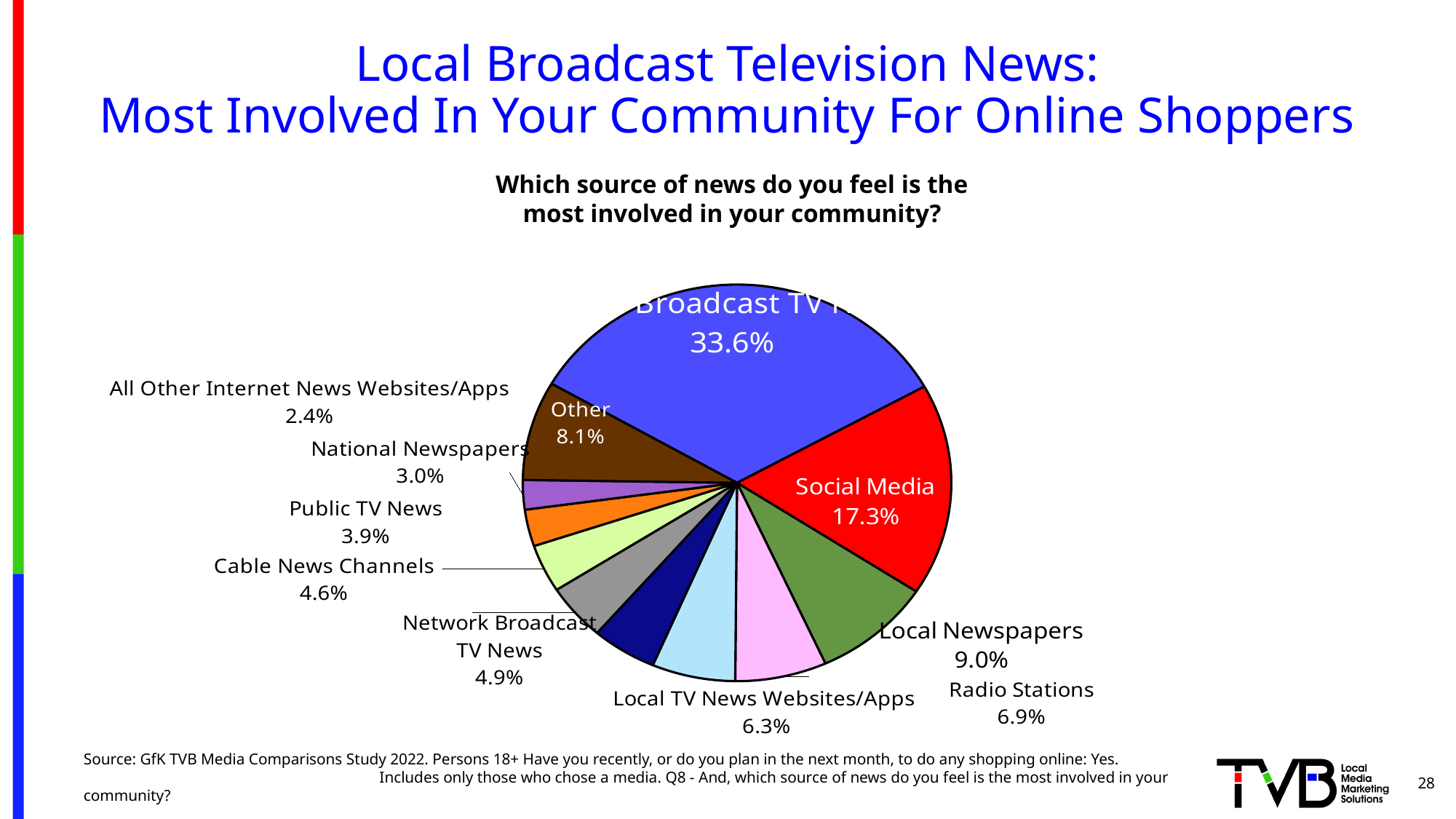
What percentage is shown for the Other slice? 8.1% Which is larger, Public TV News or National Newspapers? Public TV News What kind of chart is shown on the slide? pie chart How many percentage points higher is Social Media than Local Newspapers? 8.3% Which category has the smallest slice of the pie? All Other Internet News Websites/Apps How many slices does the pie chart have? 11 What percentage is shown for Radio Stations? 6.9% What percentage is shown for Local Newspapers? 9.0% What is the percentage of the largest slice in the pie? 33.6% What colour is the Social Media slice? red What share of respondents chose Social Media as the news source most involved in their community? 17.3% What percentage is shown for Cable News Channels? 4.6%